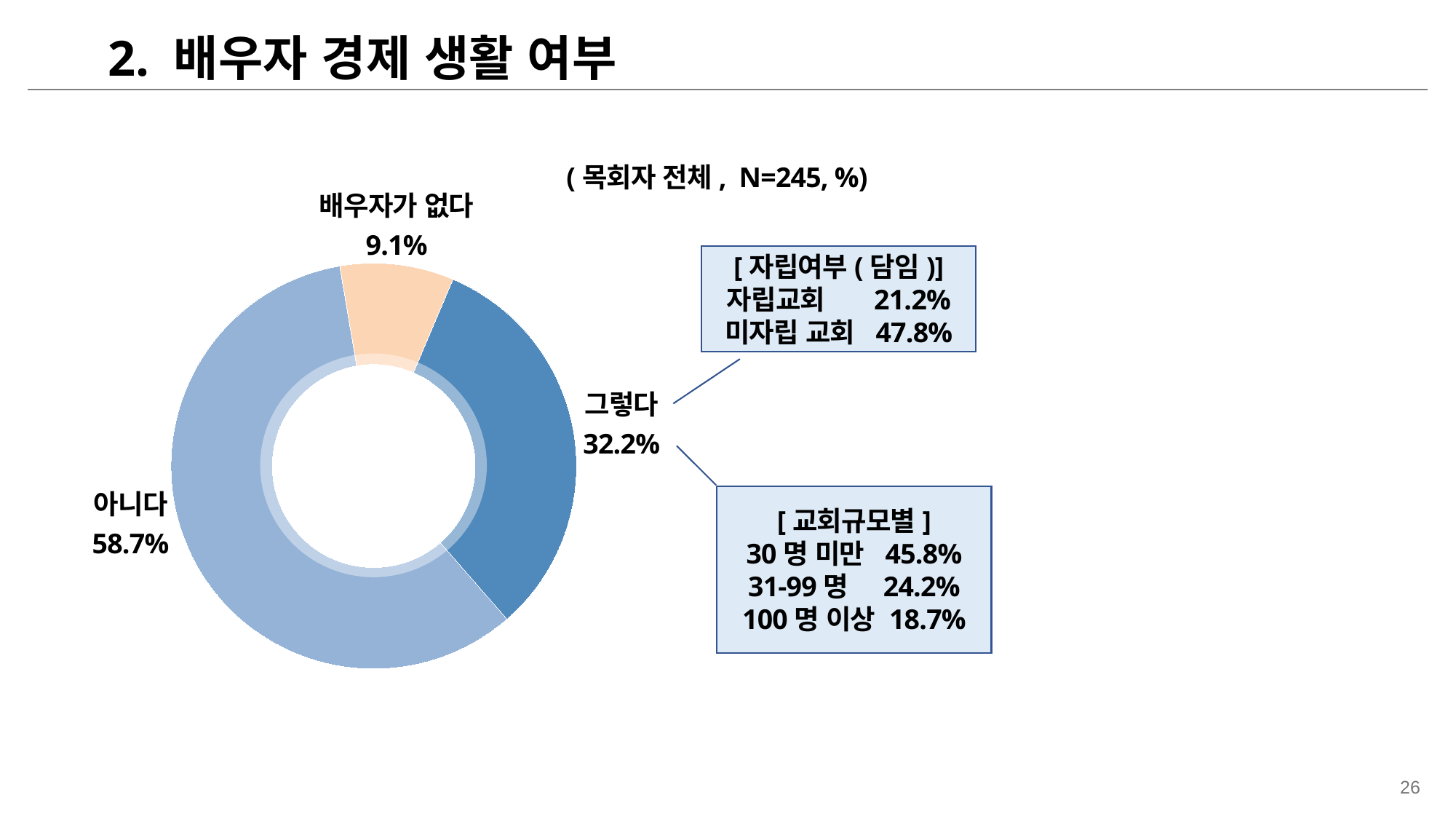
Which category has the largest share? 아니다 What is the difference between 아니다 and 그렇다? 26.5% In the [ 자립여부 ( 담임 )] box, what is the value for 미자립 교회? 47.8% What is the value for 아니다? 58.7% Which category has the smallest share? 배우자가 없다 How many categories does the chart show? 3 What is the value for 그렇다? 32.2% What is the value for 배우자가 없다? 9.1% What kind of chart is shown on the slide? Doughnut (pie) chart In the [ 교회규모별 ] box, what is the value for 30 명 미만? 45.8% Which is larger, 그렇다 or 배우자가 없다? 그렇다 What is the sample size (N) stated on the slide? 245